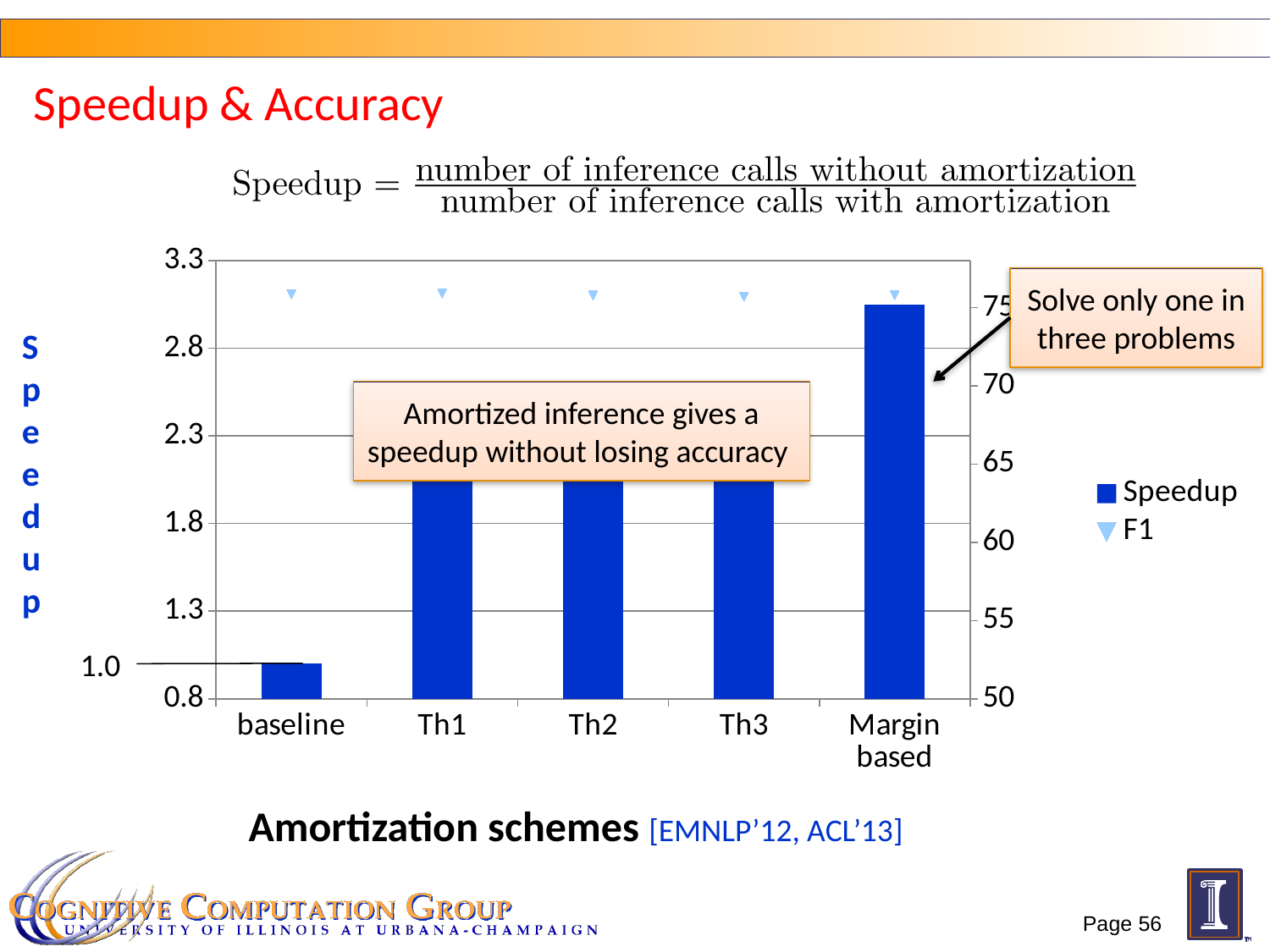
How many series does the legend list? 2 What are the two series listed in the legend? Speedup and F1 What is the speedup value for baseline? 1.0 Which category has the lowest speedup? baseline Which category has the highest speedup? Margin based Is the F1 value for baseline greater or less than 70 on the right axis? greater How many amortization schemes (categories) are shown on the x axis? 5 What kind of chart is shown on the slide? bar chart Is the speedup for Margin based greater or less than 2.8? greater Which has a larger speedup, Margin based or Th2? Margin based Is the speedup for Th1 greater or less than 1.8? greater What is the label of the x axis? Amortization schemes